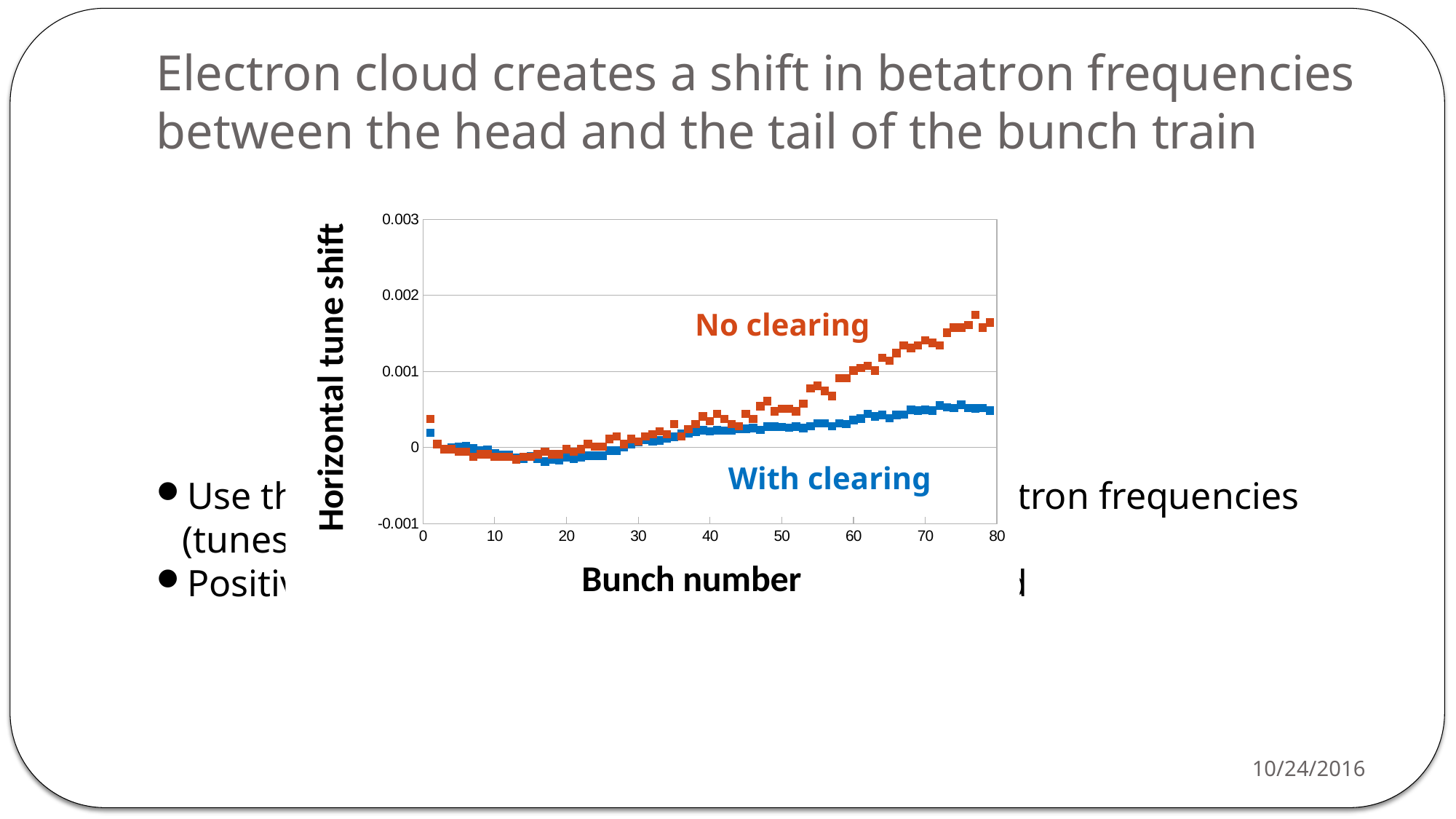
What kind of chart is shown on the slide? Scatter plot Does the No clearing series generally rise or fall as the bunch number increases from 20 to 80? rise At bunch number 70, which series has the higher horizontal tune shift, No clearing or With clearing? No clearing Which series reaches the highest horizontal tune shift on the chart? No clearing Is the value of the With clearing series at bunch number 40 greater or less than 0.001? less Is the value of the No clearing series at bunch number 80 greater or less than 0.002? less How many data series are plotted on the chart? 2 Is the value of the No clearing series at bunch number 80 greater or less than 0.001? greater What is the title of the vertical axis? Horizontal tune shift What are the names of the two series labelled on the chart? No clearing and With clearing